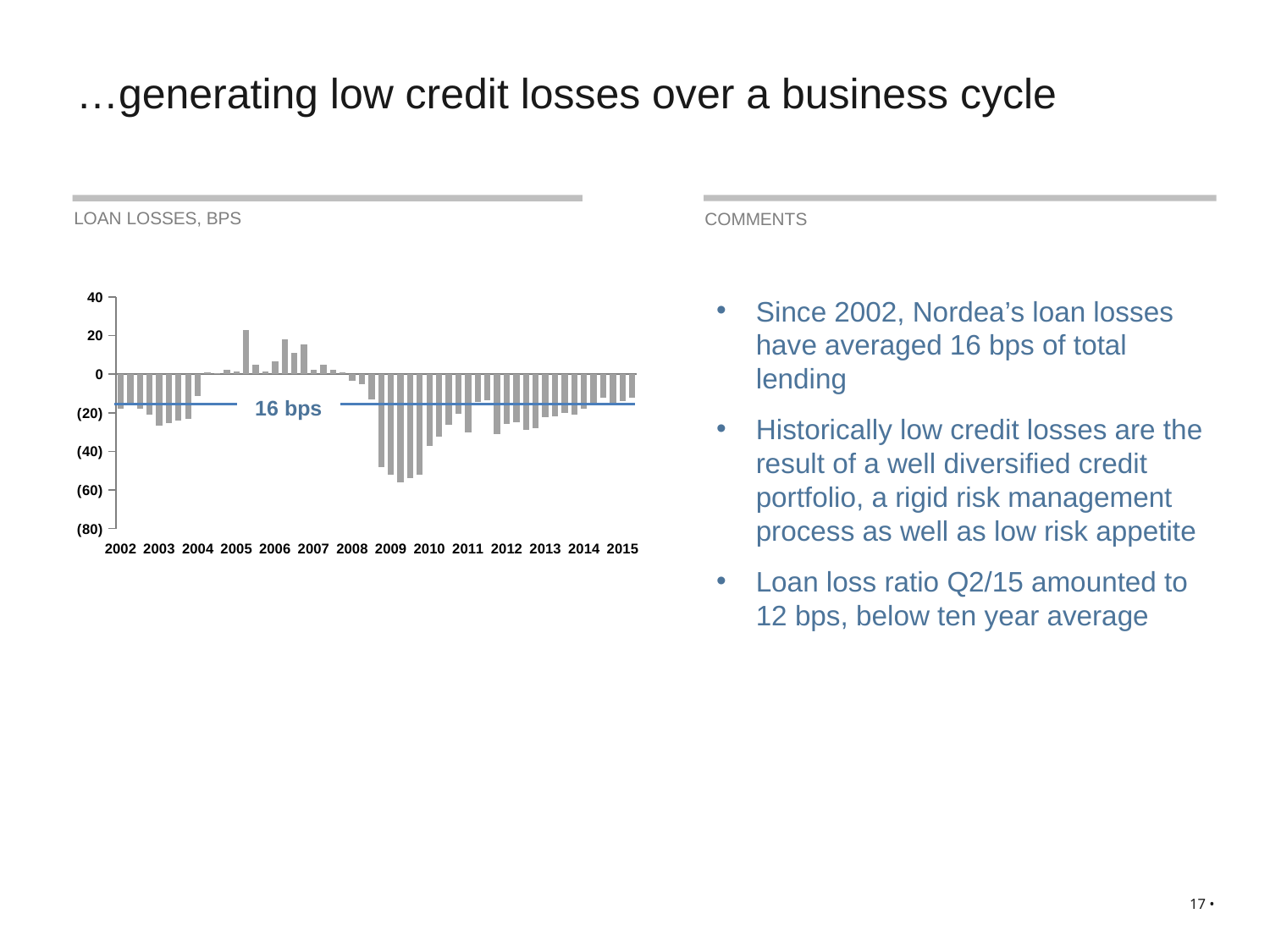
From 2002 to 2005, do the bars on the loan losses chart move up or down? up How many years are labelled on the x axis of the loan losses chart? 14 Is the highest bar on the loan losses chart greater or less than 40? less What is the lowest value shown on the y axis of the loan losses chart? (80) What kind of chart is shown under "LOAN LOSSES, BPS"? Bar chart What value is labelled on the horizontal line drawn across the loan losses chart? 16 bps Are the bars in 2009 on the loan losses chart lower or higher than the bars in 2014? lower Is the lowest bar on the loan losses chart greater or less than (40)? less What is the highest value shown on the y axis of the loan losses chart? 40 Is the first bar of 2002 on the loan losses chart greater or less than 0? less What is the title of the chart on the left of the slide? LOAN LOSSES, BPS In which year does the loan losses chart show its tallest positive bar? 2005